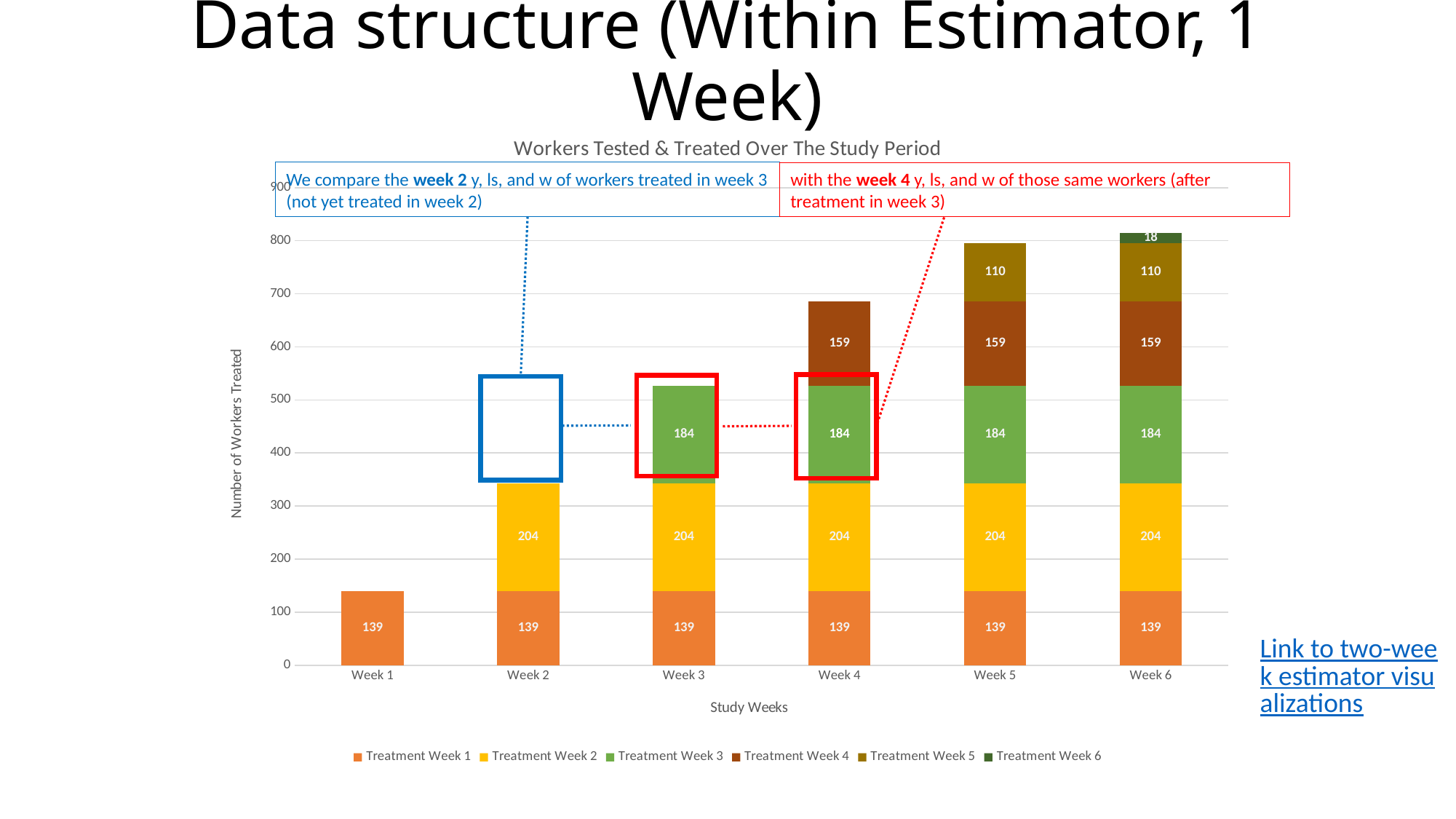
How many series does the legend list? 6 What is the total of the stacked bar for Week 3? 527 Do the total bar heights rise or fall from Week 1 to Week 6? Rise How many study weeks are shown on the x axis? 6 What is the value of the Treatment Week 2 segment in Week 5? 204 What type of chart is shown on the slide? Stacked bar chart What is the difference between the Treatment Week 2 segment and the Treatment Week 1 segment in Week 2? 65 What is the total of the stacked bar for Week 6? 814 Which study week has the lowest total number of workers treated? Week 1 What is the value of the Treatment Week 6 segment in Week 6? 18 What is the title of the chart? Workers Tested & Treated Over The Study Period What is the value of the Treatment Week 3 segment in Week 4? 184